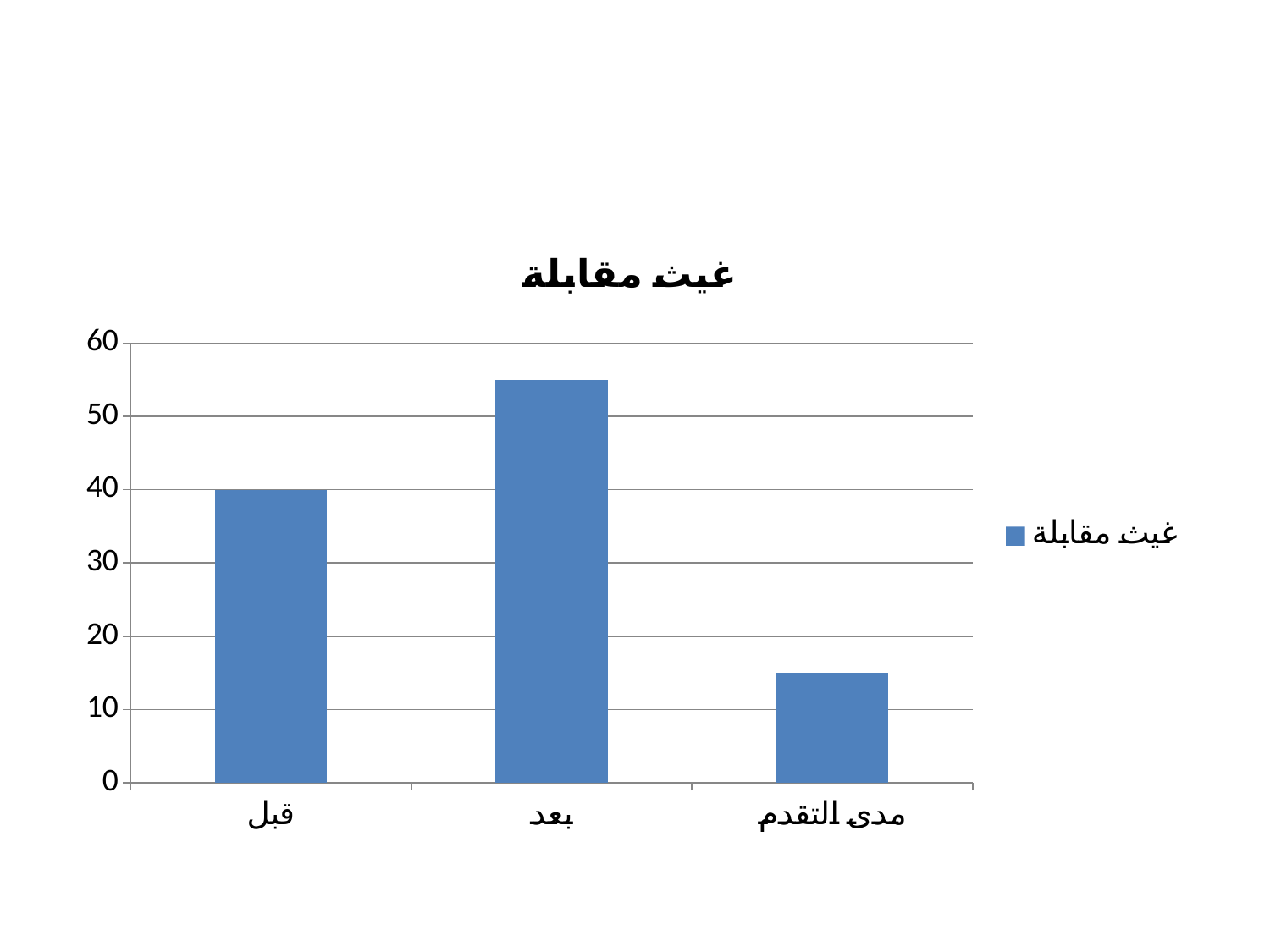
How many series does the legend list? 1 Which category has the highest value? بعد Is the value for مدى التقدم greater or less than 20? less Which category has the lowest value? مدى التقدم What is the title of the chart? غيث مقابلة Which is larger, the value for قبل or the value for بعد? بعد What is the name of the series shown in the legend? غيث مقابلة Is the value for بعد greater or less than 50? greater What is the value for قبل? 40 What type of chart is shown on the slide? bar chart How many categories are shown on the x axis of the chart? 3 Is the value for بعد greater or less than 60? less